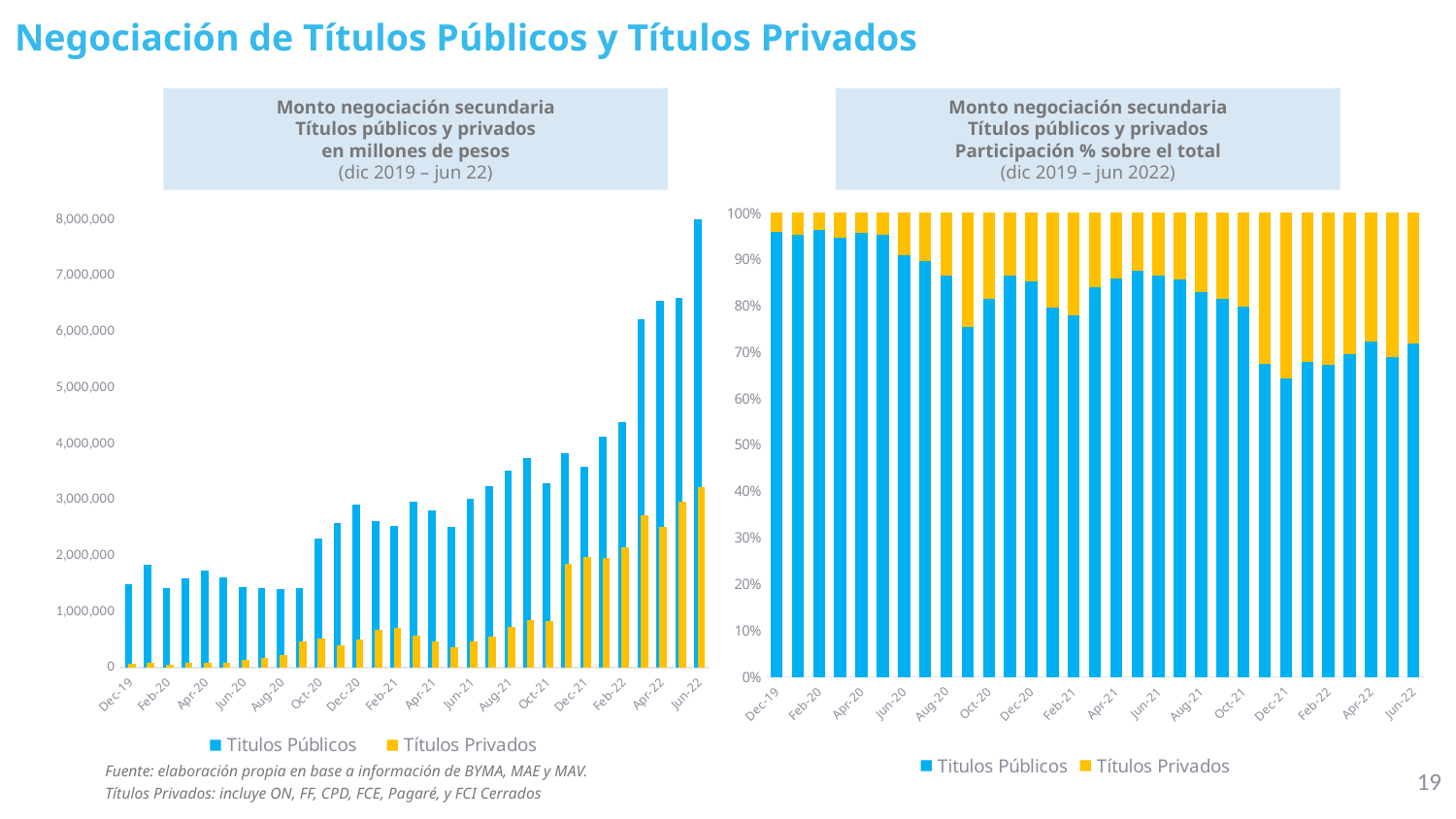
What is the time period shown in the subtitle of the right chart? dic 2019 – jun 2022 In the left chart (millions of pesos), is the value for Títulos Privados in Dec-19 greater or less than 500,000? less What are the two series named in the legend of the right chart? Títulos Públicos and Títulos Privados In the left chart (millions of pesos), is the value for Títulos Privados in Jun-22 greater or less than 2,000,000? greater In the right chart (Participación % sobre el total), is the share of Títulos Públicos in Dec-21 greater or less than 70%? less In the right chart (Participación % sobre el total), does the share of Títulos Privados generally rise or fall from Dec-19 to Jun-22? rise In the left chart (millions of pesos), which month has the highest value for Títulos Públicos? Jun-22 In the left chart (millions of pesos), which is larger in Jun-22: Títulos Públicos or Títulos Privados? Títulos Públicos What kind of chart is the left chart, 'Monto negociación secundaria ... en millones de pesos'? bar chart How many series does the legend of the left chart list? 2